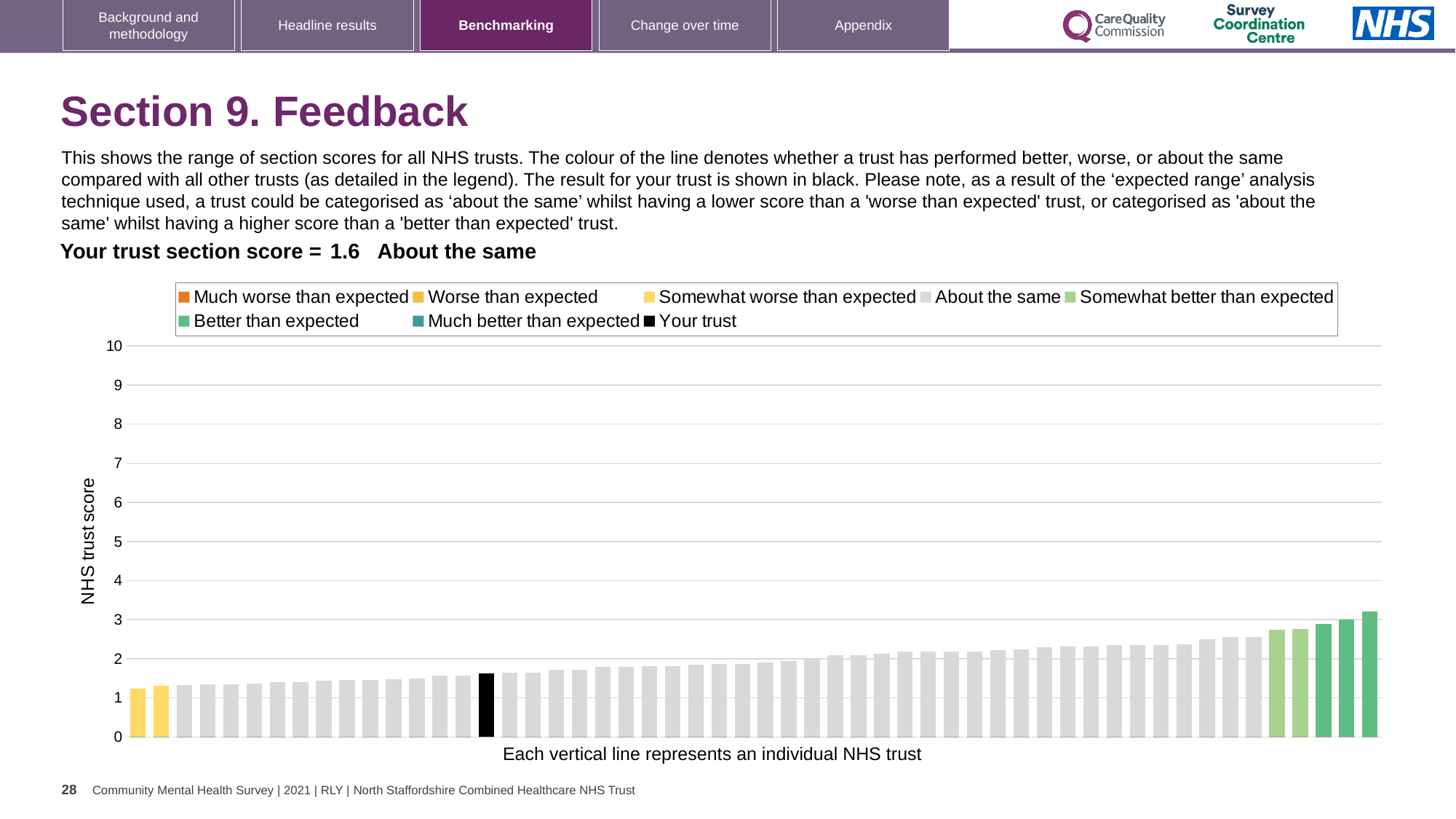
What is the label on the vertical axis of the chart? NHS trust score How is your trust's section score categorised compared with other trusts? About the same What colour is used for the bar representing your trust? Black How many entries does the chart legend list? 8 Which legend category does the shortest bar belong to? Somewhat worse than expected Is the value for your trust (the black bar) greater or less than 2? less Is the value of the shortest bar greater or less than 2? less Which legend category does the tallest bar belong to? Better than expected What is the section score for your trust shown on the slide? 1.6 Do the bar values rise or fall from left to right along the x axis? Rise What kind of chart is shown on the slide? Bar chart Is the value of the tallest bar greater or less than 3? greater